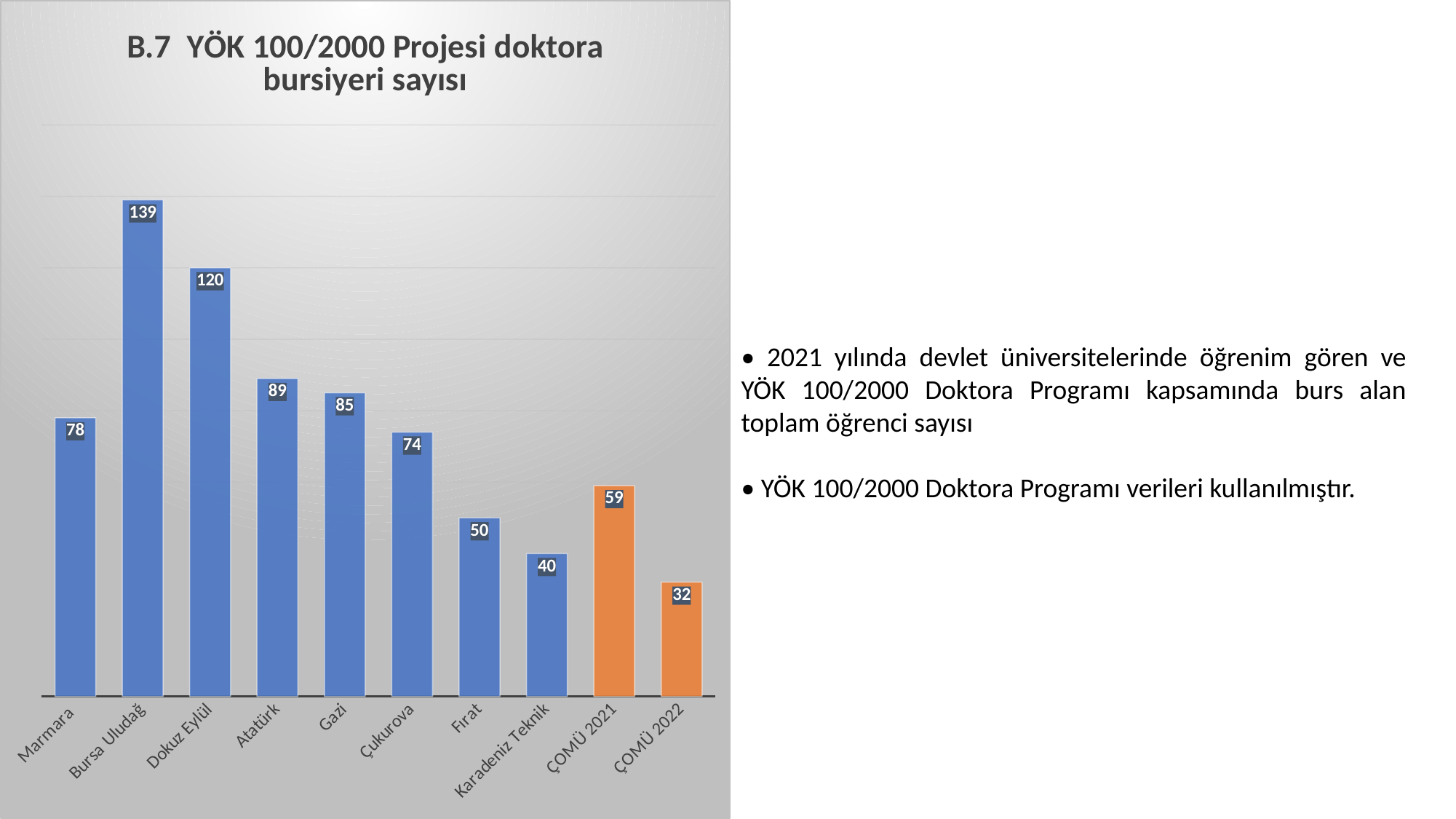
Which is larger, the value for Atatürk or the value for Gazi? Atatürk Which category has the lowest value? ÇOMÜ 2022 What is the difference between the values for ÇOMÜ 2021 and ÇOMÜ 2022? 27 What is the title of the chart? B.7 YÖK 100/2000 Projesi doktora bursiyeri sayısı What is the value for ÇOMÜ 2021? 59 What is the value for Marmara? 78 What is the value for Bursa Uludağ? 139 What is the difference between the values for Bursa Uludağ and Dokuz Eylül? 19 What is the value for ÇOMÜ 2022? 32 How many categories are shown on the x axis? 10 Which category has the highest value? Bursa Uludağ What kind of chart is shown on the slide? Bar chart